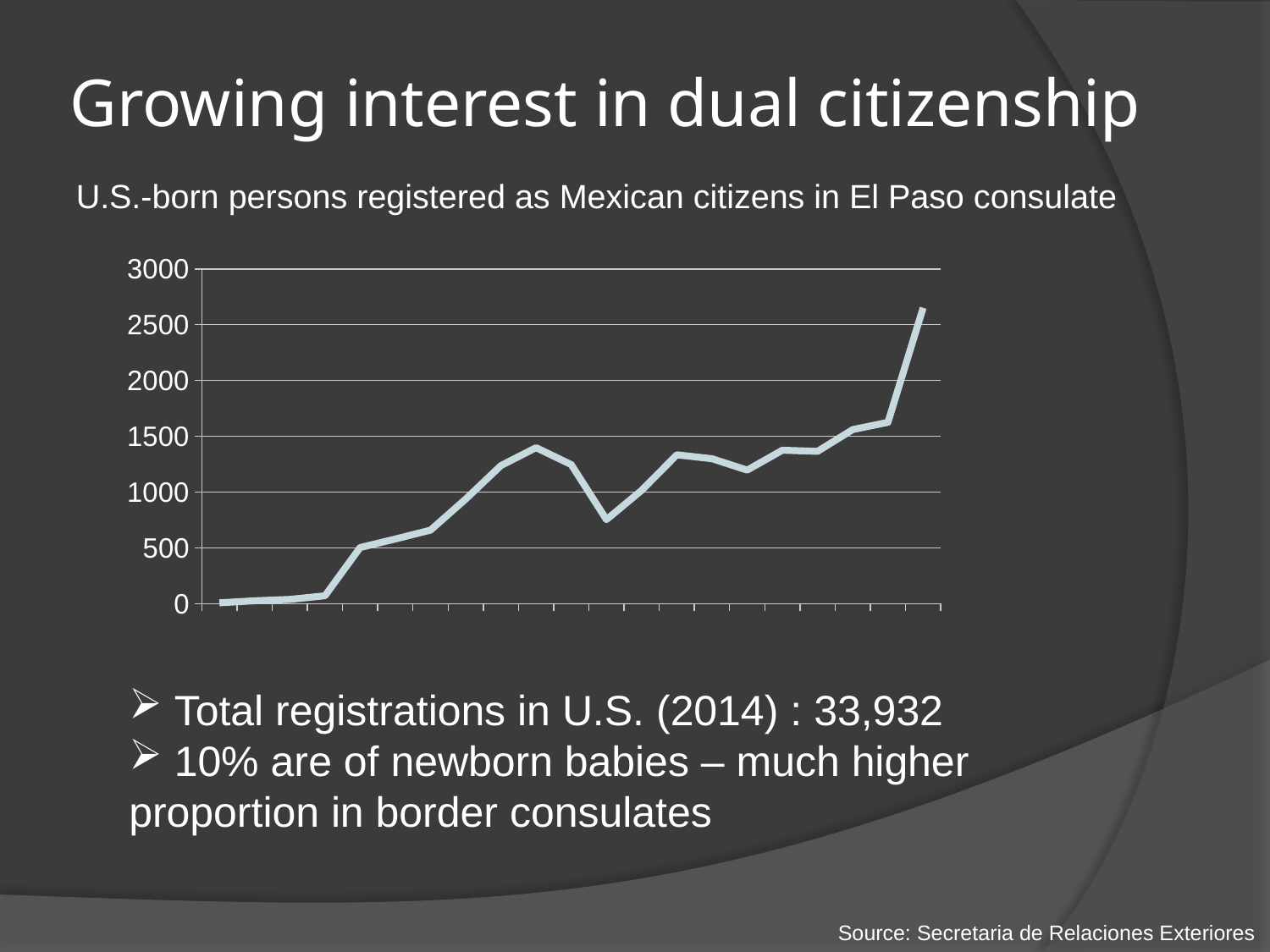
How many lines (data series) are plotted on the chart? 1 Overall, do the values in the line chart rise or fall from left to right? rise What does the chart show, according to the text above it? U.S.-born persons registered as Mexican citizens in El Paso consulate Which point on the line has the highest value, the leftmost or the rightmost? rightmost What kind of chart is shown on the slide? line chart What is the highest value shown on the chart's vertical axis? 3000 Is the value at the dip in the middle of the line (after the first peak) greater or less than 1000? less Is the highest value reached by the line greater or less than 2000? greater Which is larger, the value at the first point of the line or the value at the last point? the last point Is the value at the rightmost (final) point of the line greater or less than 2500? greater Which point on the line has the lowest value, the leftmost or the rightmost? leftmost